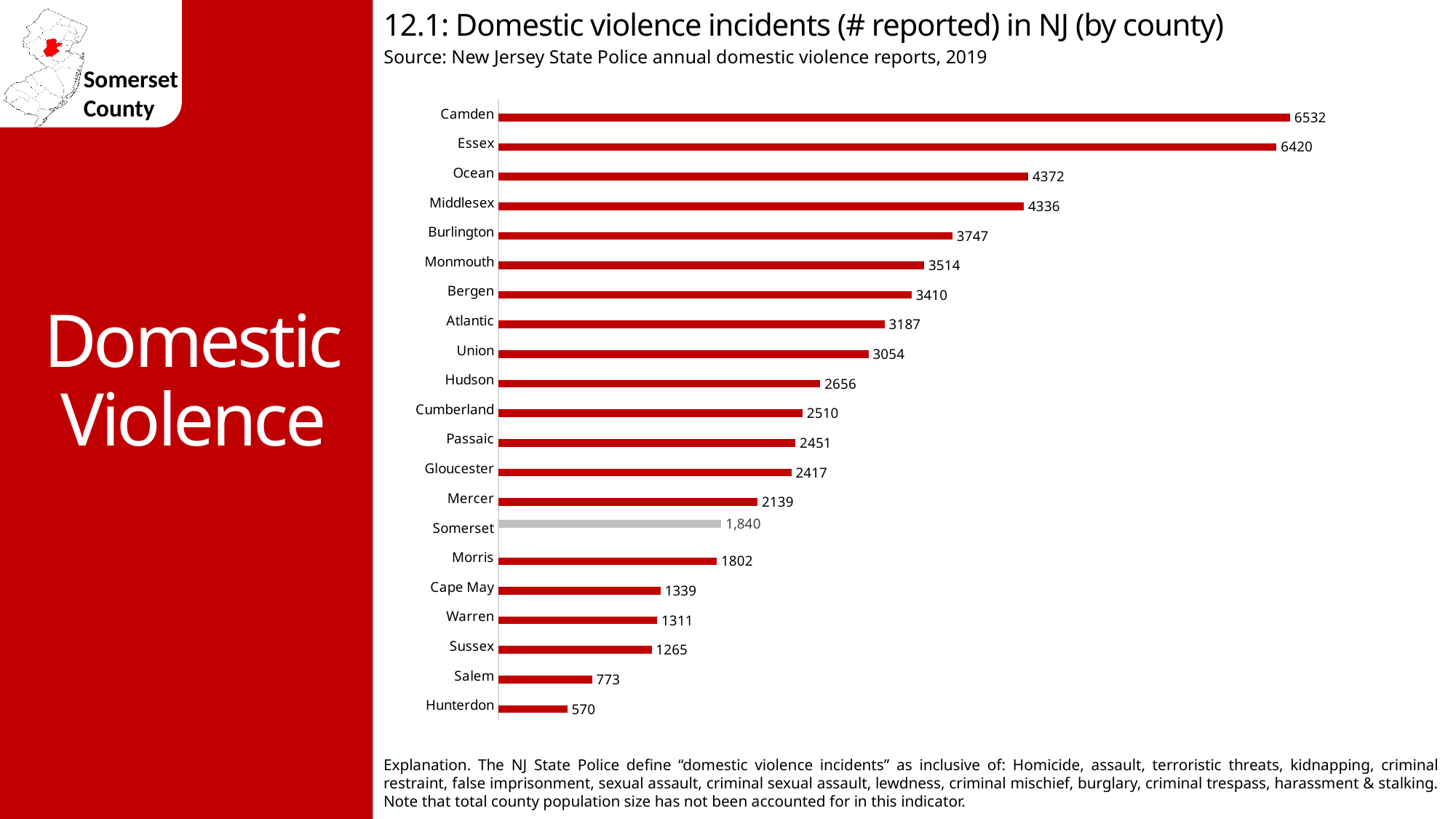
Which county has more reported incidents, Burlington or Monmouth? Burlington How many counties are shown in the chart? 21 What is the number of domestic violence incidents reported for Somerset County? 1,840 Which county has the highest number of reported domestic violence incidents? Camden What is the difference between the values for Camden and Essex? 112 What is the difference between the values for Salem and Hunterdon? 203 Which county has more reported incidents, Morris or Cape May? Morris Which county's bar is shown in grey rather than red? Somerset How many domestic violence incidents were reported in Camden County? 6532 What value is shown for Hunterdon County? 570 Which county has the lowest number of reported domestic violence incidents? Hunterdon What type of chart is used on this slide? Bar chart